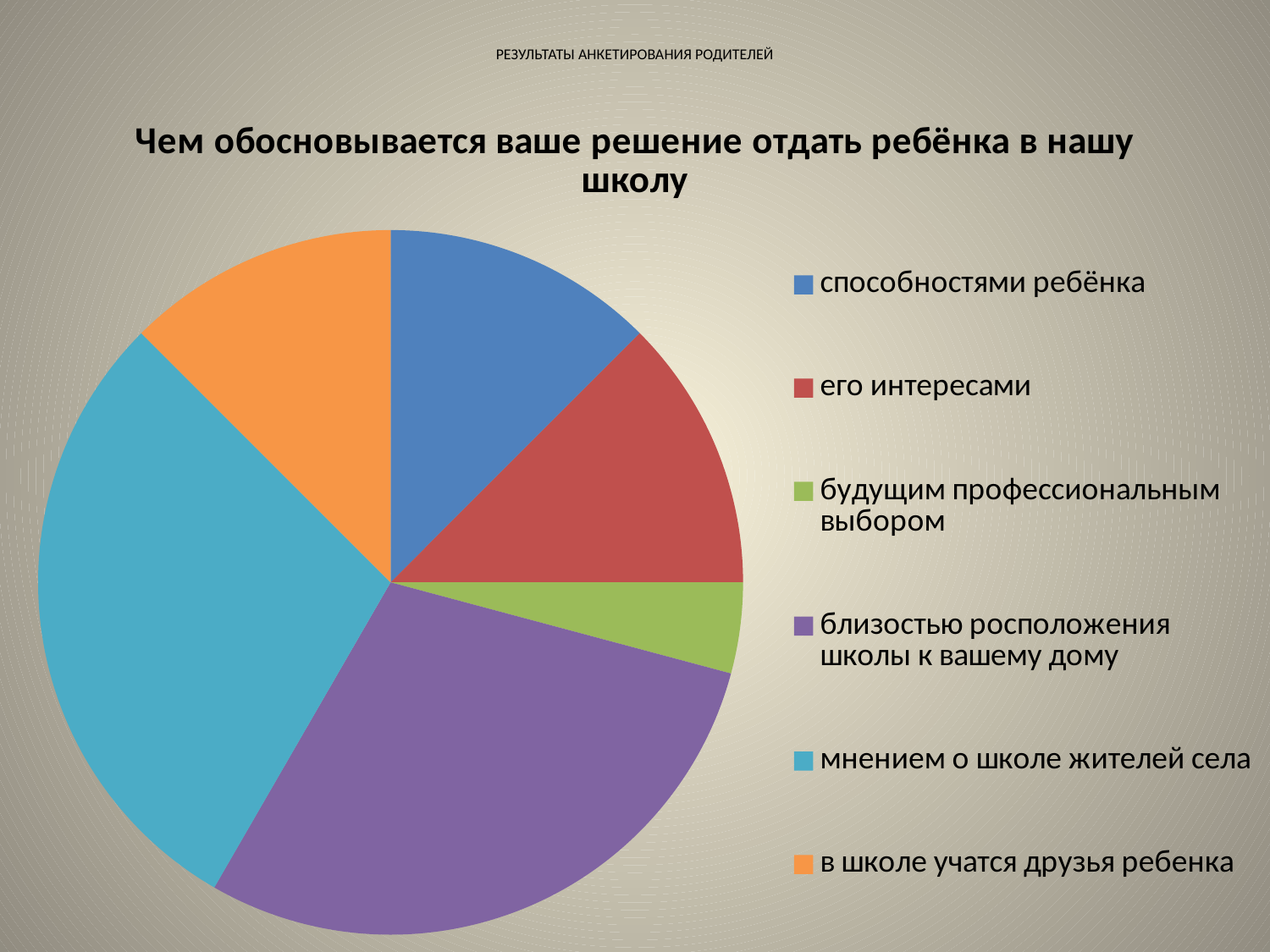
Which slice is larger: "мнением о школе жителей села" or "способностями ребёнка"? мнением о школе жителей села What is the title of the pie chart? Чем обосновывается ваше решение отдать ребёнка в нашу школу What kind of chart is shown on the slide? pie chart Which category has the smallest slice in the pie chart? будущим профессиональным выбором Which slice is larger: "его интересами" or "будущим профессиональным выбором"? его интересами Which slice is larger: "близостью росположения школы к вашему дому" or "будущим профессиональным выбором"? близостью росположения школы к вашему дому Which category is shown in green in the pie chart? будущим профессиональным выбором How many categories does the pie chart have? 6